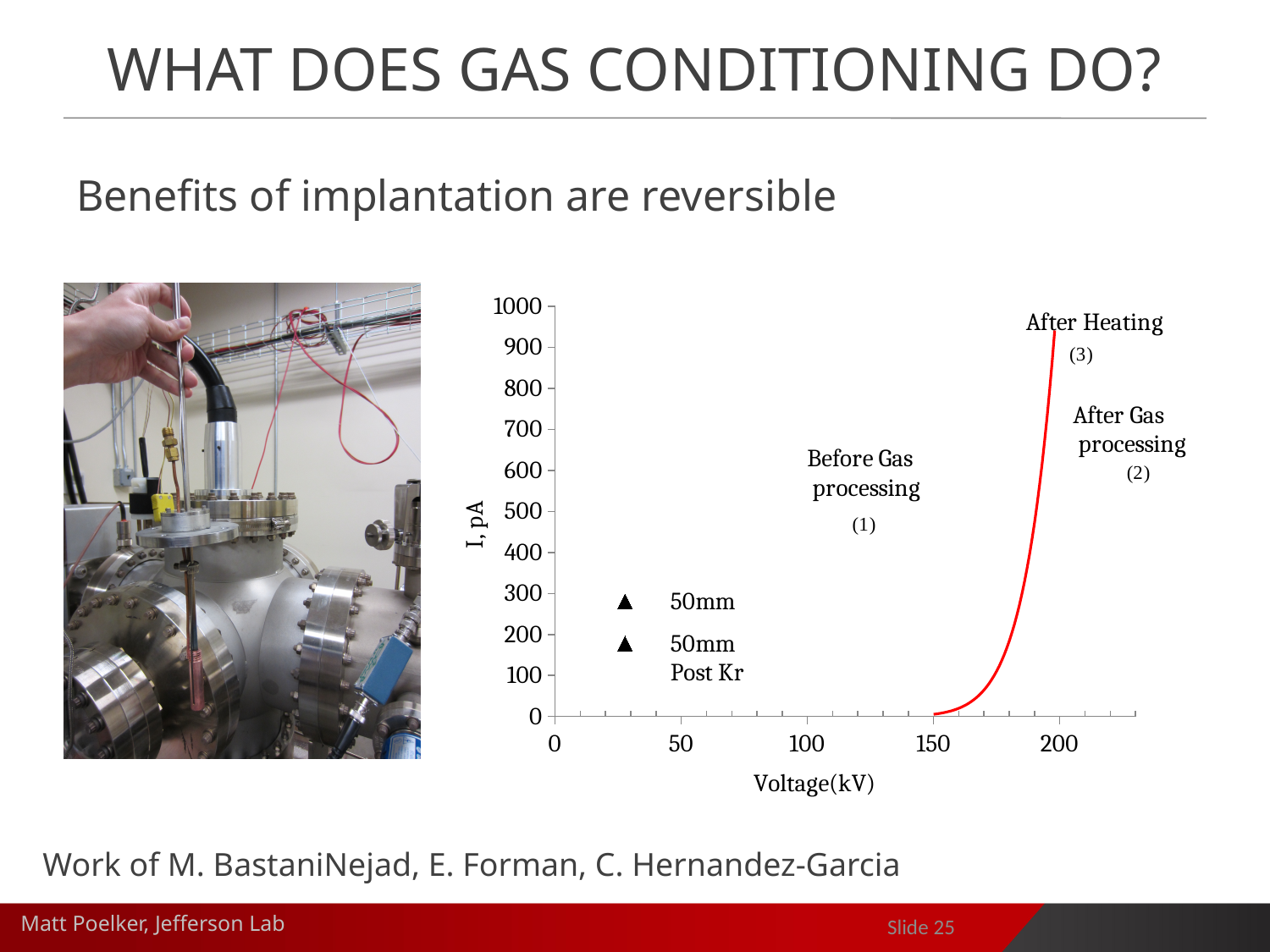
How many entries does the chart's legend list? 2 Is the current at 175 kV greater or less than 500 pA? less What is the label of the x axis of the chart? Voltage(kV) What is the highest labelled tick on the x axis of the chart? 200 What is the label of the y axis of the chart? I, pA Does the current rise or fall as the voltage increases along the x axis? rises What kind of chart is shown on the slide? line chart Is the current at 190 kV greater or less than 100 pA? greater